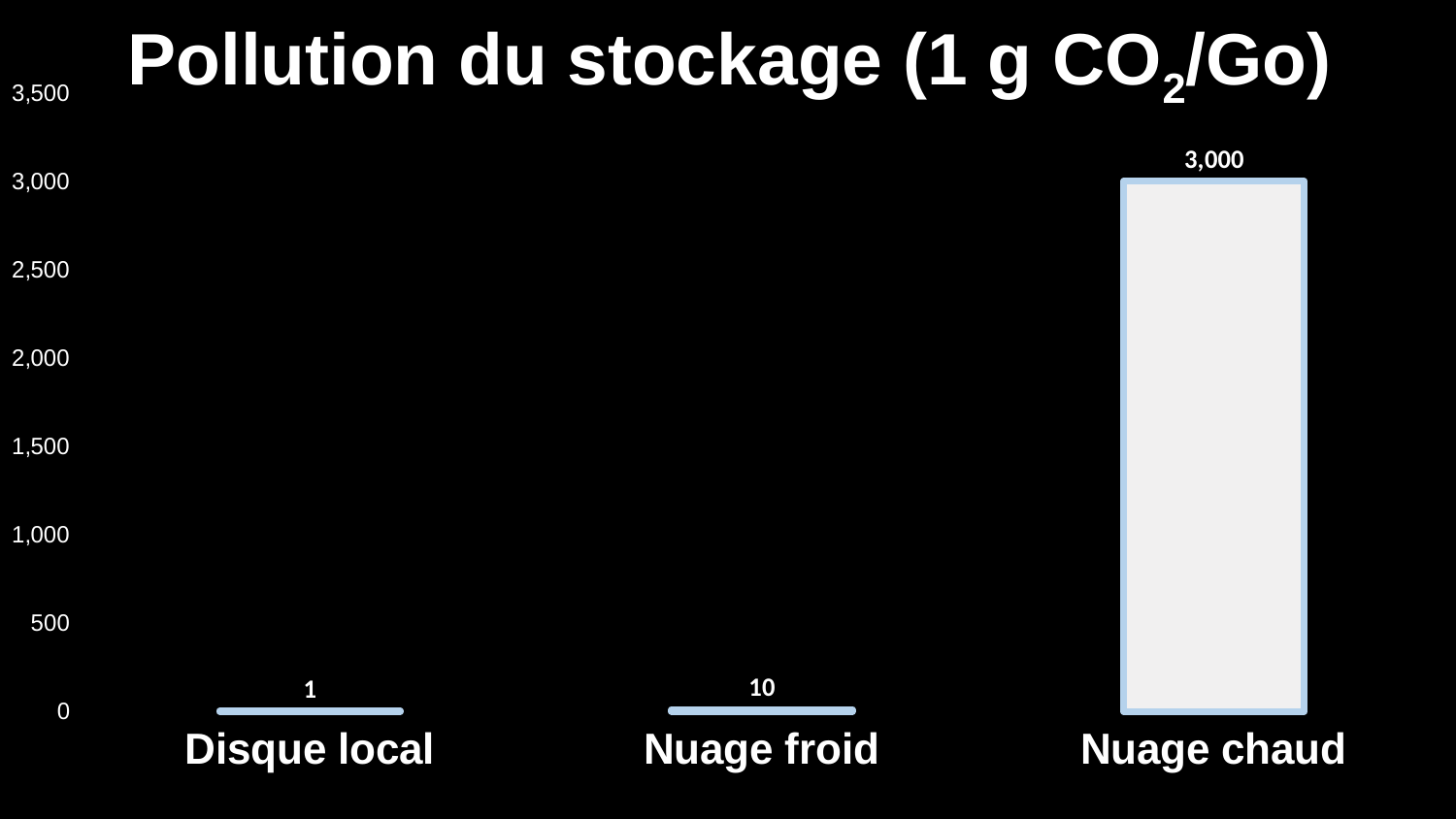
What is the value for Nuage froid? 10 How many categories are shown on the x axis? 3 What is the value for Nuage chaud? 3,000 What is the difference between the values for Nuage froid and Disque local? 9 What is the title of the chart? Pollution du stockage (1 g CO2/Go) What kind of chart is shown on the slide? bar chart Which category has the highest value? Nuage chaud Which category has the lowest value? Disque local Is the value for Nuage chaud greater or less than 2,500? greater What is the value for Disque local? 1 What is the difference between the values for Nuage chaud and Nuage froid? 2,990 Which is larger, the value for Nuage froid or the value for Disque local? Nuage froid